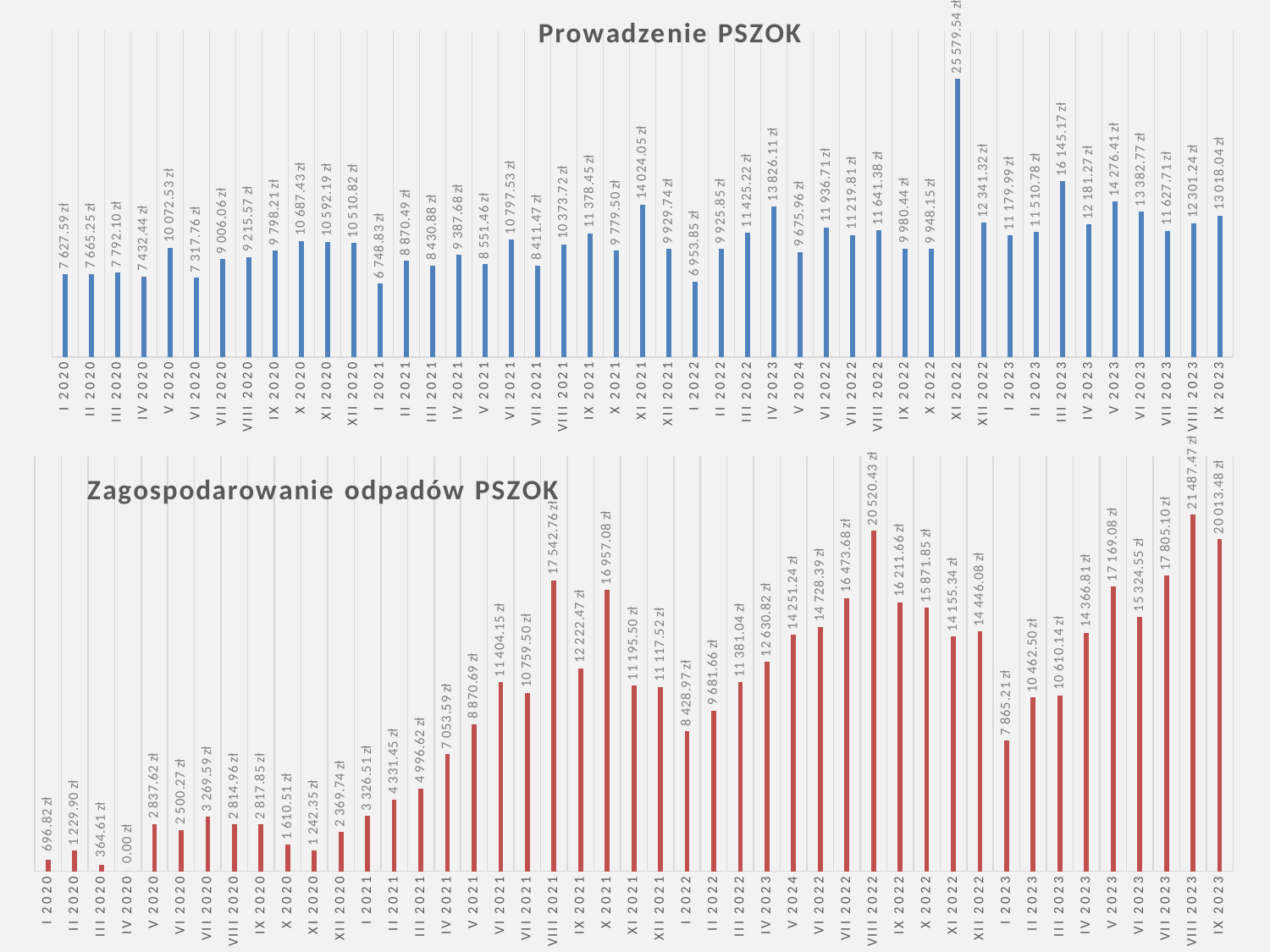
In the 'Zagospodarowanie odpadów PSZOK' chart, which month has the highest value? VIII 2023 In the 'Zagospodarowanie odpadów PSZOK' chart, what is the difference between the values for VIII 2023 and IX 2023? 1 473.99 zł In the 'Prowadzenie PSZOK' chart, which month has the highest value? XI 2022 In the 'Zagospodarowanie odpadów PSZOK' chart, which is larger: the value for VIII 2021 or X 2021? VIII 2021 In the 'Zagospodarowanie odpadów PSZOK' chart, what is the value for VIII 2022? 20 520.43 zł What colour are the bars in the 'Zagospodarowanie odpadów PSZOK' chart? red In the 'Zagospodarowanie odpadów PSZOK' chart, do the values rise or fall from I 2021 to VI 2021? rise What kind of chart is the 'Prowadzenie PSZOK' chart? bar chart In the 'Prowadzenie PSZOK' chart, what is the value for XI 2022? 25 579.54 zł In the 'Zagospodarowanie odpadów PSZOK' chart, which month has the lowest value? IV 2020 In the 'Prowadzenie PSZOK' chart, what is the difference between the values for XI 2022 and XII 2022? 13 238.22 zł In the 'Prowadzenie PSZOK' chart, which month has the lowest value? I 2021